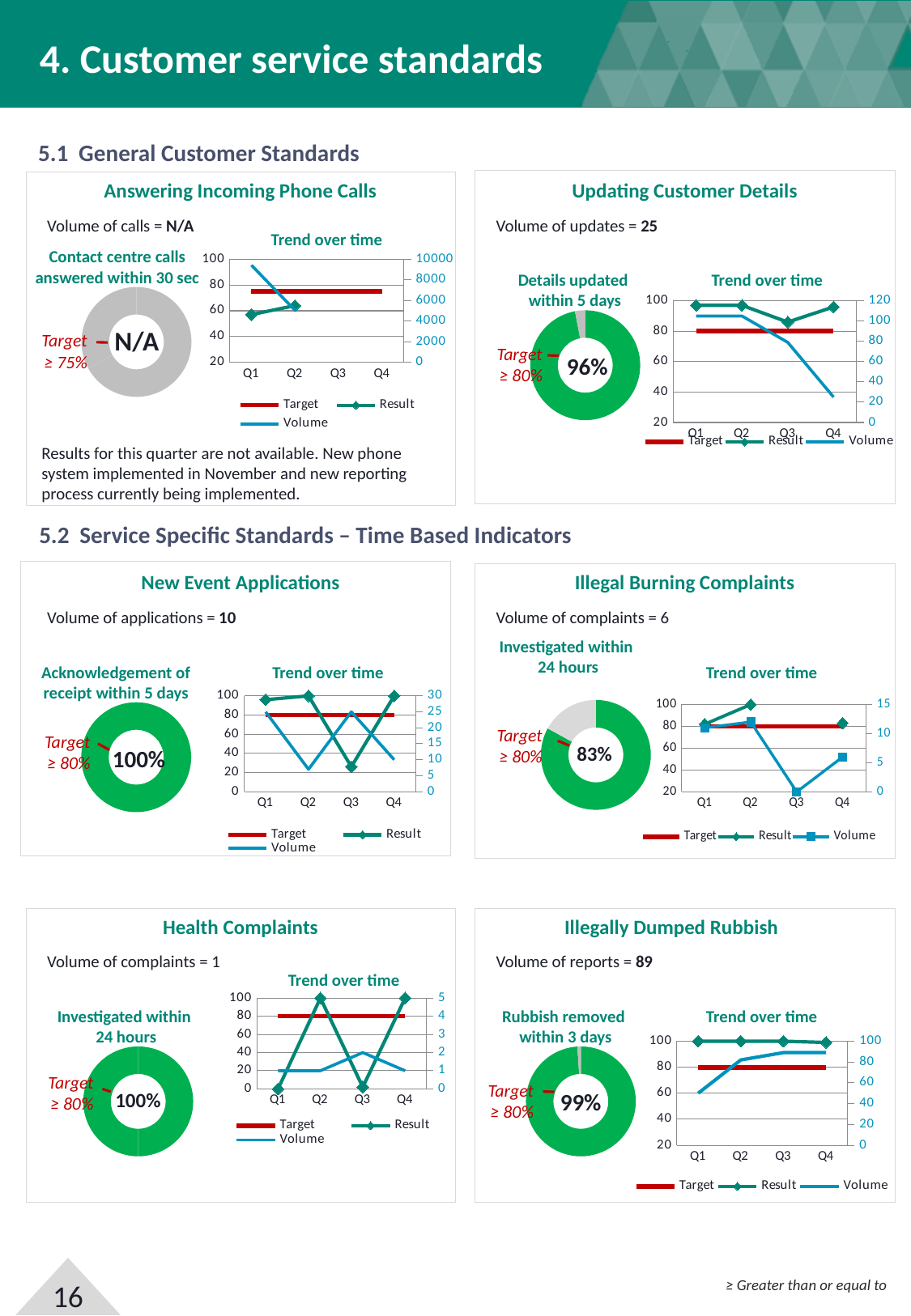
In the Illegal Burning Complaints Trend over time chart, which quarter has the higher Result value, Q1 or Q2? Q2 In the Illegally Dumped Rubbish panel, what percentage is shown in the centre of the donut chart for rubbish removed within 3 days? 99% How many quarters are shown on the x axis of the Trend over time chart in the Health Complaints panel? 4 In the Updating Customer Details Trend over time chart, is the Volume value for Q4 greater or less than 40 on the right axis? less In the Updating Customer Details panel, what percentage is shown in the centre of the donut chart for details updated within 5 days? 96% In the Health Complaints Trend over time chart, is the Result value for Q2 greater or less than 80? greater In the New Event Applications panel, what percentage is shown in the centre of the donut chart for acknowledgement of receipt within 5 days? 100% What kind of chart is the Trend over time chart in the New Event Applications panel? Line chart In the Answering Incoming Phone Calls panel, what target is shown next to the donut chart? ≥ 75% In the Illegal Burning Complaints panel, what percentage is shown in the centre of the donut chart for investigated within 24 hours? 83% In the Updating Customer Details Trend over time chart, does the Volume line rise or fall from Q1 to Q4? Falls How many series does the legend list for the Trend over time chart in the Illegally Dumped Rubbish panel? 3